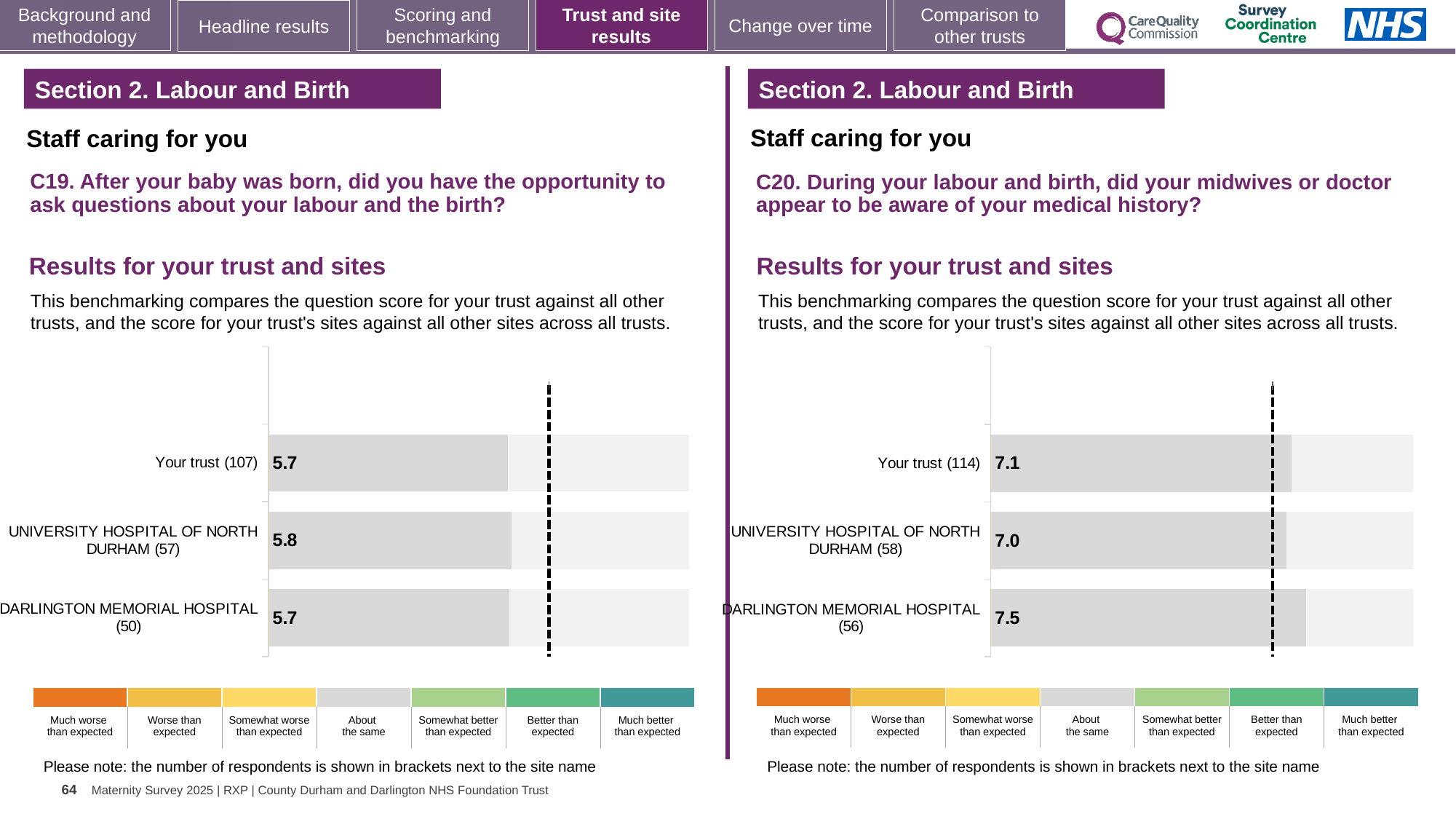
In the C20 chart on the right, which site or trust has the lowest score? UNIVERSITY HOSPITAL OF NORTH DURHAM In the C19 chart on the left, how many respondents are shown in brackets for DARLINGTON MEMORIAL HOSPITAL? 50 In the C20 chart on the right, which has the larger score: Your trust or UNIVERSITY HOSPITAL OF NORTH DURHAM? Your trust In the C19 chart on the left, what is the score for UNIVERSITY HOSPITAL OF NORTH DURHAM? 5.8 In the C19 chart on the left, what is the score for Your trust? 5.7 What type of chart is used in the C20 chart on the right? Bar chart In the C19 chart on the left, which site or trust has the highest score? UNIVERSITY HOSPITAL OF NORTH DURHAM In the C20 chart on the right, what is the difference between the scores for DARLINGTON MEMORIAL HOSPITAL and Your trust? 0.4 How many bars are shown in the C19 chart on the left? 3 In the C20 chart on the right, what is the score for DARLINGTON MEMORIAL HOSPITAL? 7.5 In the C20 chart on the right, which site or trust has the highest score? DARLINGTON MEMORIAL HOSPITAL In the C20 chart on the right, what is the score for Your trust? 7.1